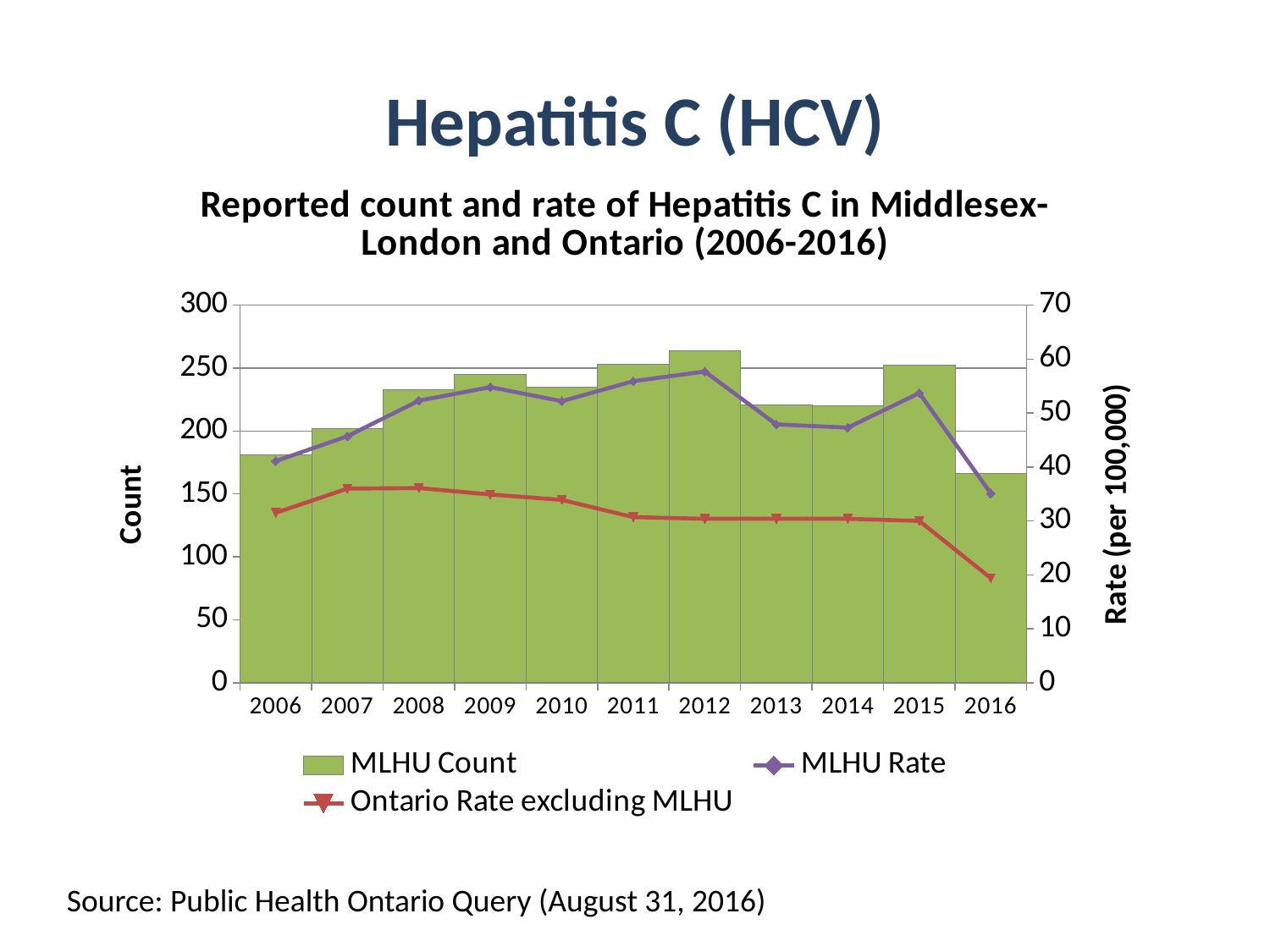
Does the Ontario Rate excluding MLHU rise or fall from 2008 to 2016? Fall How many years are shown on the x axis of the chart? 11 In which year is the MLHU Count bar the tallest? 2012 In 2012, which is higher: the MLHU Rate or the Ontario Rate excluding MLHU? MLHU Rate Which series is plotted as green bars in the chart? MLHU Count In which year is the MLHU Count bar the shortest? 2016 Is the MLHU Count for 2016 greater or less than 200? less In which year is the MLHU Rate at its lowest? 2016 Is the MLHU Count for 2012 greater or less than 250? greater How many series does the chart legend list? 3 Is the MLHU Rate for 2016 greater or less than 40 per 100,000? less What kind of chart is shown on the slide? A combination bar and line chart